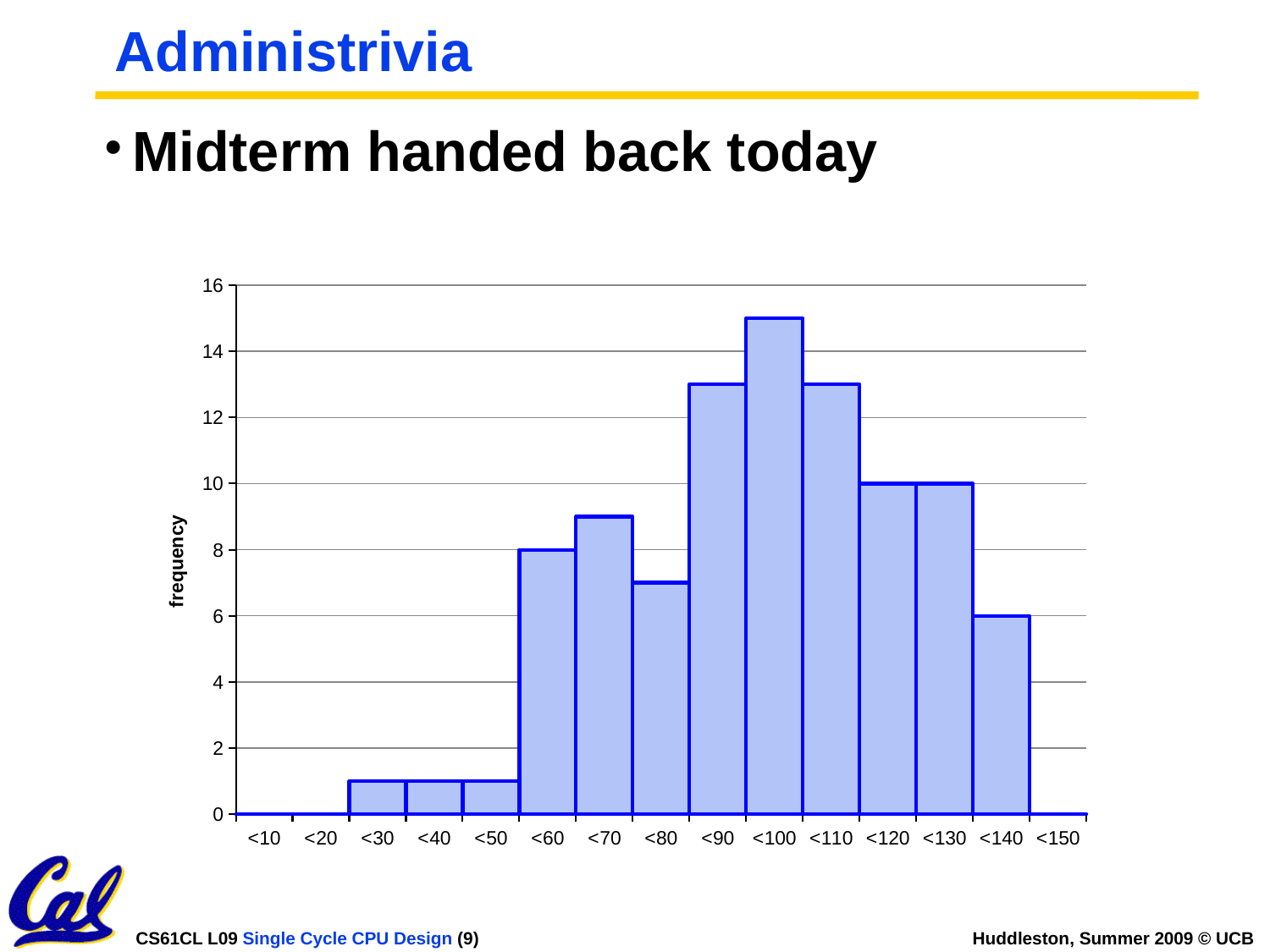
Is the frequency for the <100 bin greater or less than 14? greater What is the frequency for the <10 bin? 0 Is the frequency for the <30 bin greater or less than 2? less Which score bin has the highest frequency? <100 What is the label on the y axis of the chart? frequency How many score bins are shown along the x axis of the chart? 15 What kind of chart is shown on the slide? bar chart What is the difference in frequency between the <120 bin and the <140 bin? 4 What is the frequency for the <120 bin? 10 What is the frequency for the <60 bin? 8 What is the frequency for the <140 bin? 6 Which bin has the larger frequency, <90 or <70? <90